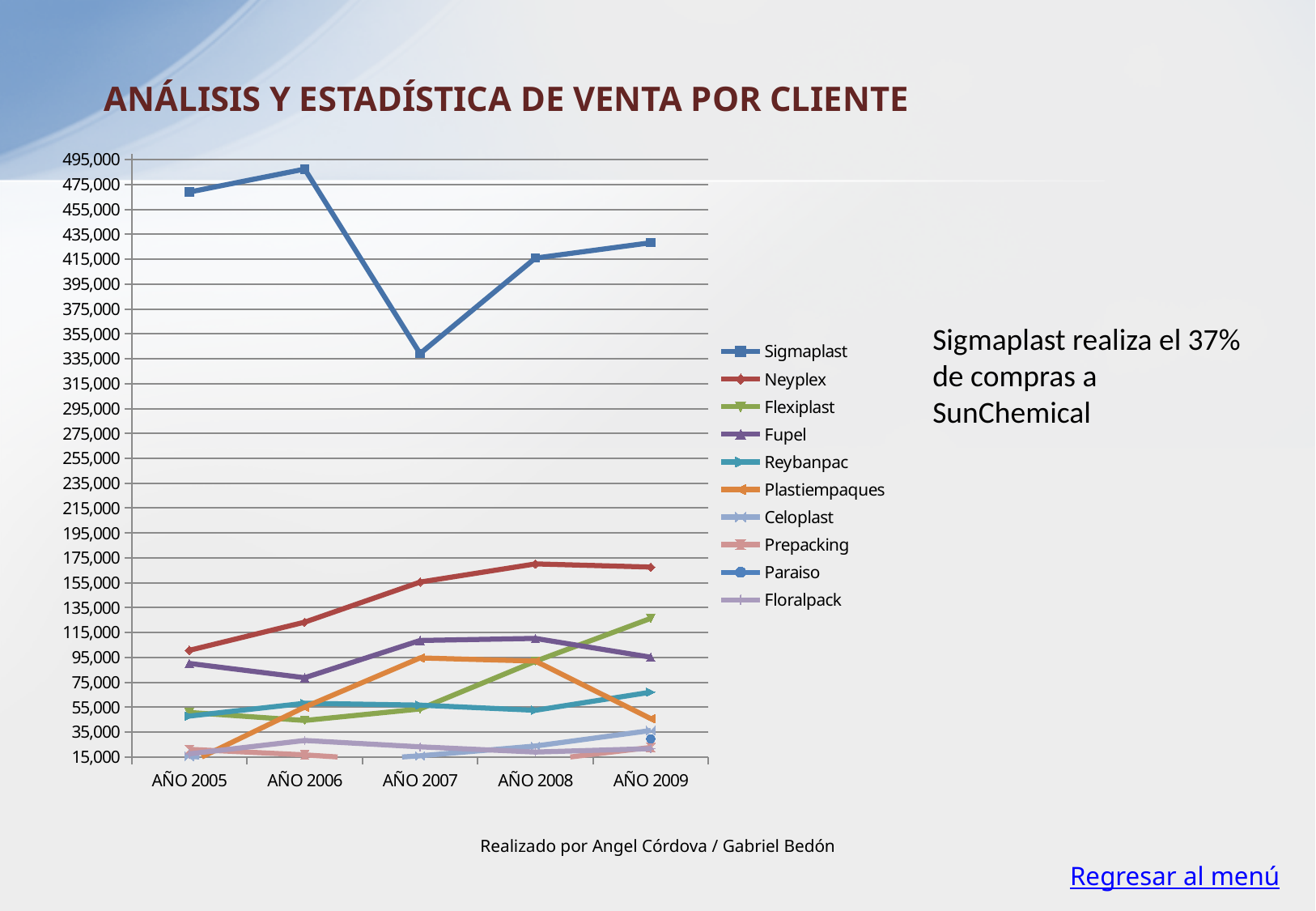
Does the Flexiplast line rise or fall from AÑO 2006 to AÑO 2009? rise What kind of chart is shown on the slide? line chart How many series does the legend list? 10 How many years are shown on the x axis? 5 Which client has the highest values across all years? Sigmaplast In which year is the Sigmaplast value lowest? AÑO 2007 Is the Sigmaplast value for AÑO 2007 greater or less than 355,000? less Which is larger in AÑO 2009, the Neyplex value or the Fupel value? Neyplex Is the Fupel value for AÑO 2006 greater or less than 95,000? less What is the title of the slide containing the chart? ANÁLISIS Y ESTADÍSTICA DE VENTA POR CLIENTE Is the Neyplex value for AÑO 2008 greater or less than 155,000? greater